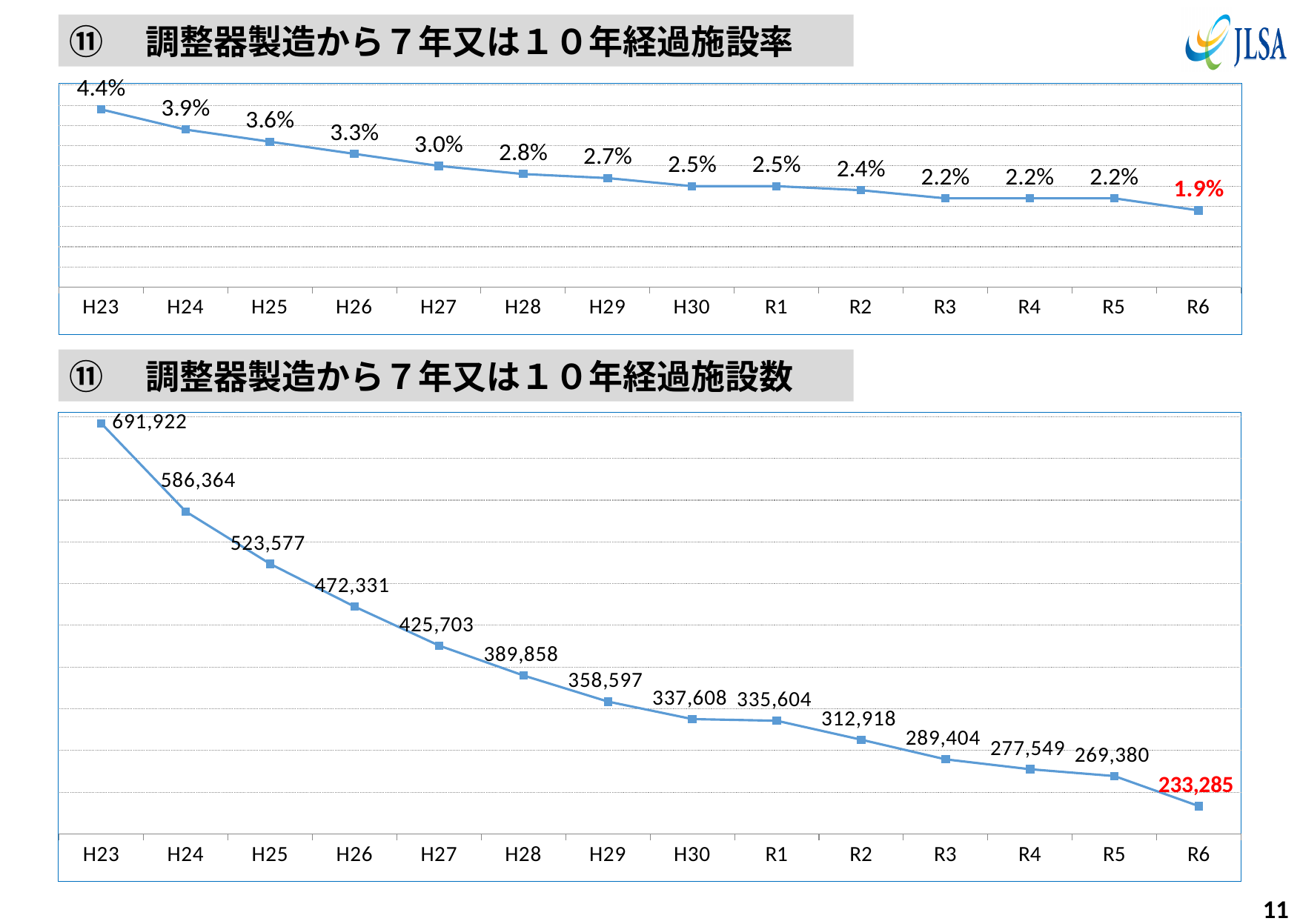
In the bottom chart (調整器製造から７年又は１０年経過施設数), which is larger, the value for H30 or the value for R1? H30 In the top chart (調整器製造から７年又は１０年経過施設率), which year has the highest value? H23 In the bottom chart (調整器製造から７年又は１０年経過施設数), what is the value for R6? 233,285 In the top chart (調整器製造から７年又は１０年経過施設率), what is the difference between the values for H23 and R6? 2.5% In the top chart (調整器製造から７年又は１０年経過施設率), how many data points are plotted? 14 In the top chart (調整器製造から７年又は１０年経過施設率), what is the value for R6? 1.9% In the top chart (調整器製造から７年又は１０年経過施設率), do the values generally rise or fall from H23 to R6? fall What kind of chart is the bottom chart (調整器製造から７年又は１０年経過施設数)? line chart In the bottom chart (調整器製造から７年又は１０年経過施設数), what is the difference between the values for H23 and H24? 105,558 In the bottom chart (調整器製造から７年又は１０年経過施設数), what is the value for H23? 691,922 In the bottom chart (調整器製造から７年又は１０年経過施設数), which year has the lowest value? R6 In the top chart (調整器製造から７年又は１０年経過施設率), what is the value for H23? 4.4%